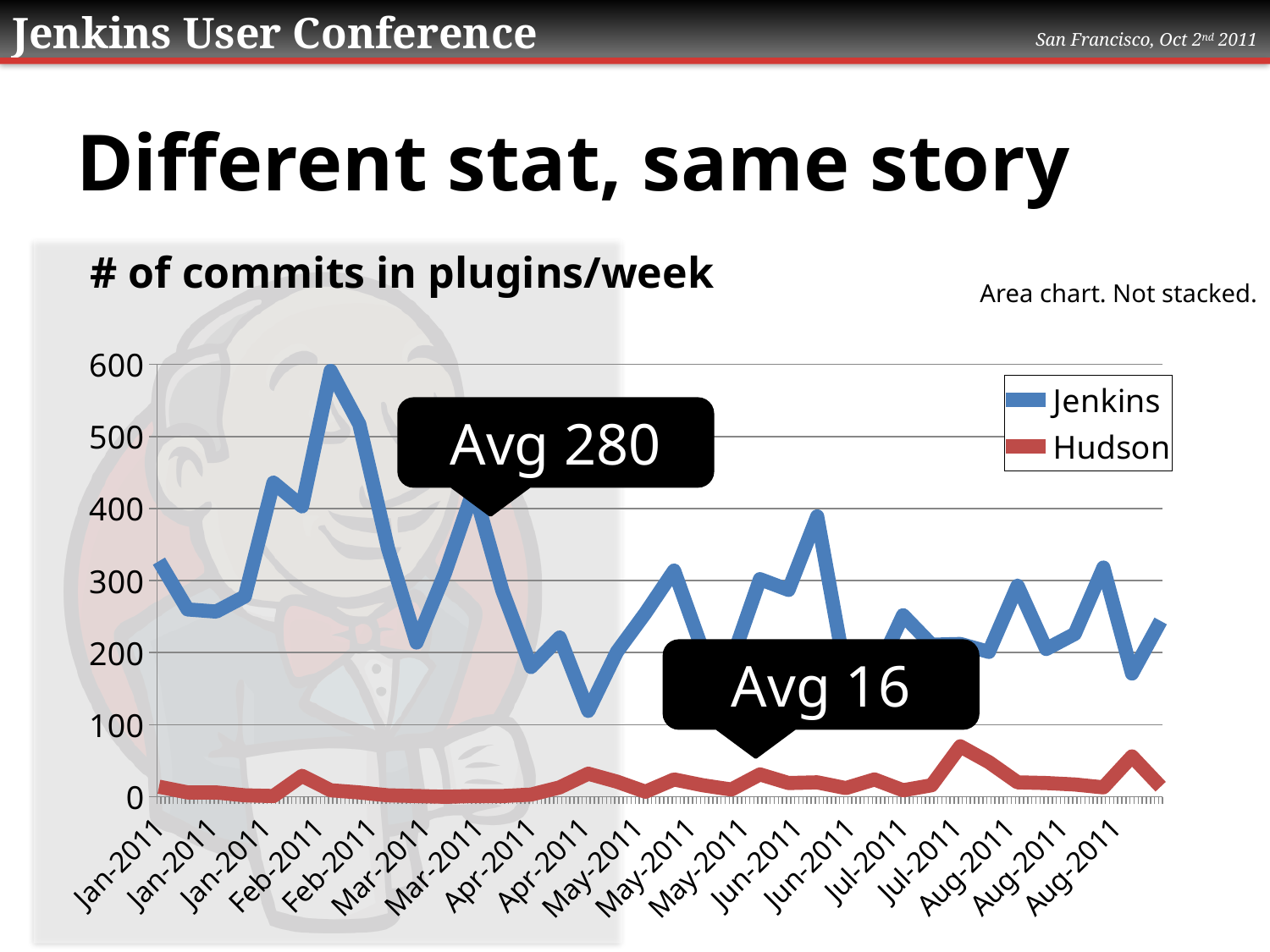
What is the difference between the Jenkins average and the Hudson average shown in the callouts? 264 How many date labels are shown along the x axis? 19 Is the Jenkins value at the first Jan-2011 point greater or less than 200? greater Is the highest value of the Jenkins series greater or less than 500? greater What average value is shown in the callout for the Hudson series? Avg 16 Is the highest value of the Hudson series greater or less than 100? less What is the title of the chart? # of commits in plugins/week Which series stays consistently lower across the whole x axis? Hudson How many series does the legend list? 2 Which series has the higher average number of commits per week, Jenkins or Hudson? Jenkins Which series is drawn in blue? Jenkins What average value is shown in the callout for the Jenkins series? Avg 280